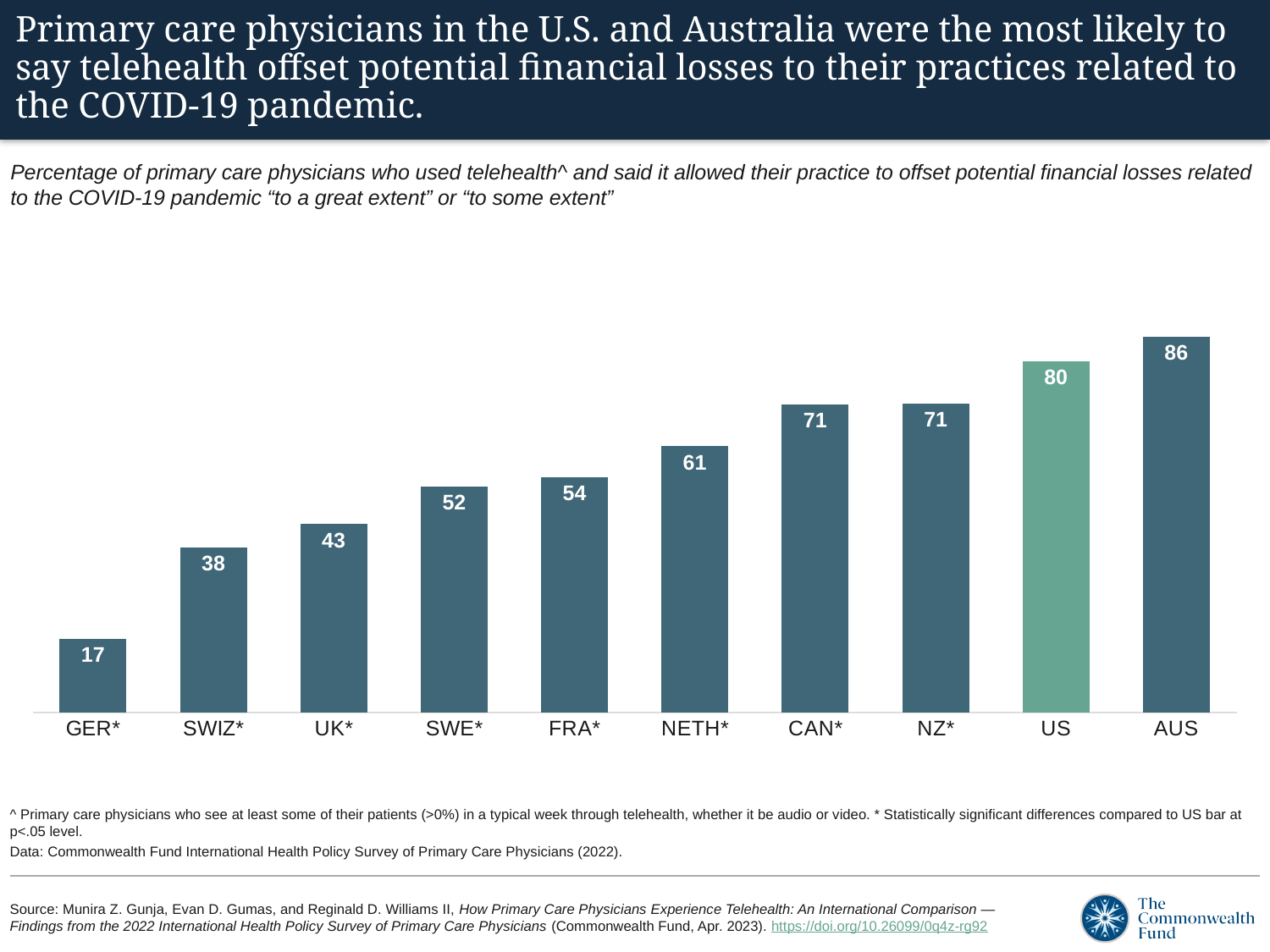
Which is larger, the value for FRA* or the value for SWIZ*? FRA* Which bar is shown in a different colour from the others? US Which country has the lowest value? GER* What is the value for NETH*? 61 What is the value for GER*? 17 Do the values rise or fall from left to right across the x axis? rise What is the difference between the values for AUS and the US? 6 What kind of chart is shown on the slide? bar chart How many countries are shown in the chart? 10 What is the value for the US? 80 Which country has the highest value? AUS What is the difference between the values for SWE* and UK*? 9